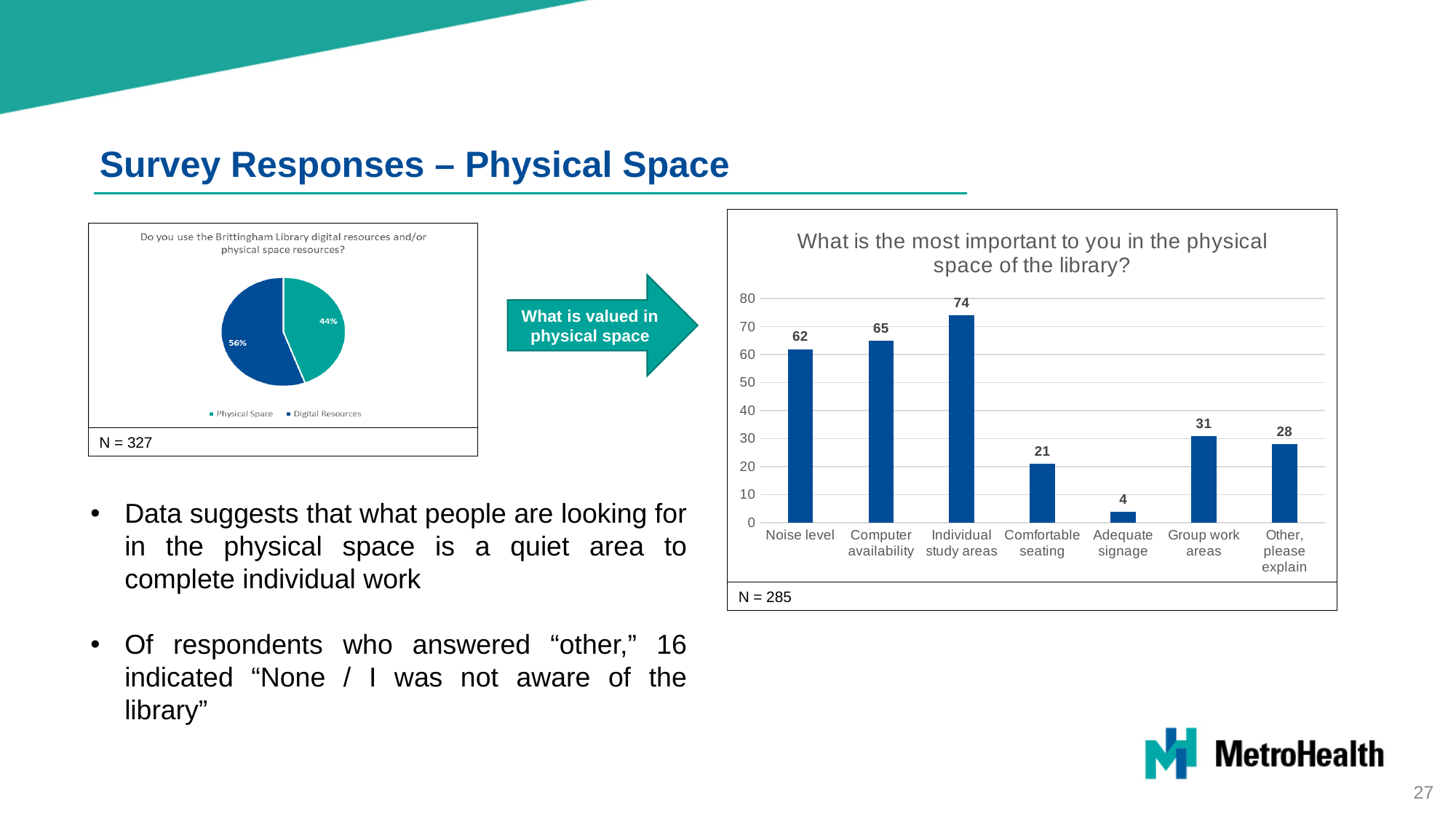
What is the title of the bar chart on the right? What is the most important to you in the physical space of the library? In the pie chart on the left, which slice is larger: Physical Space or Digital Resources? Digital Resources What kind of chart is the chart on the right of the slide? Bar chart In the bar chart on the right, what is the difference between the values for Individual study areas and Noise level? 12 In the bar chart on the right, how many categories are shown on the x axis? 7 In the bar chart on the right, what is the value for Individual study areas? 74 In the pie chart on the left, what share is labelled for Digital Resources? 56% In the pie chart on the left, what share is labelled for Physical Space? 44% In the bar chart on the right, which category has the highest value? Individual study areas In the bar chart on the right, which is larger: Group work areas or Other, please explain? Group work areas In the bar chart on the right, which category has the lowest value? Adequate signage In the bar chart on the right, what is the value for Adequate signage? 4